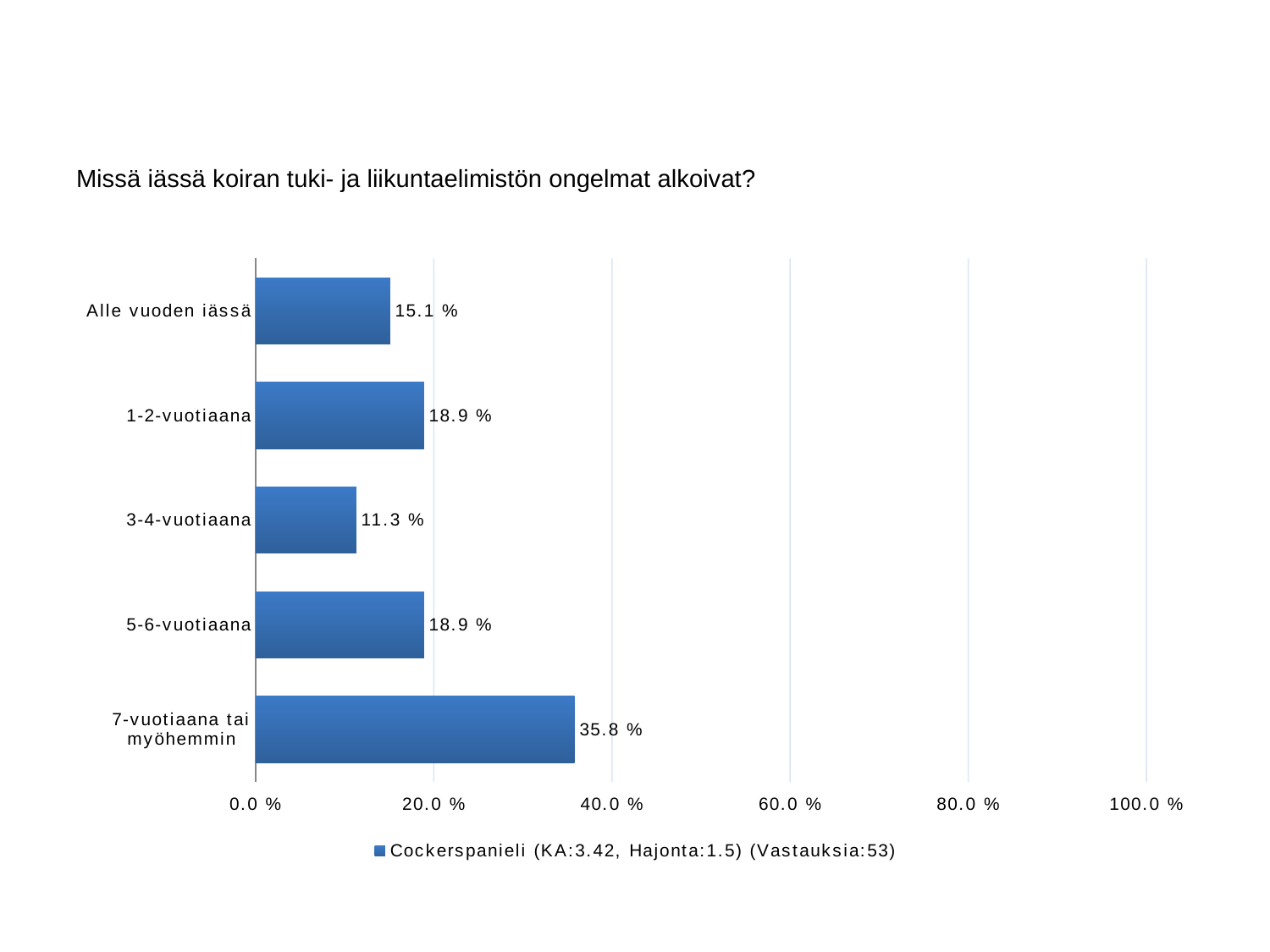
What is the value for "3-4-vuotiaana"? 11.3 % How many series does the legend list? 1 What is the title of the chart? Missä iässä koiran tuki- ja liikuntaelimistön ongelmat alkoivat? What is the difference between the values for "7-vuotiaana tai myöhemmin" and "1-2-vuotiaana"? 16.9 % What is the value for "7-vuotiaana tai myöhemmin"? 35.8 % Is the value for "7-vuotiaana tai myöhemmin" greater or less than 40.0 %? less Which is larger, the value for "Alle vuoden iässä" or the value for "3-4-vuotiaana"? Alle vuoden iässä What kind of chart is shown on the slide? bar chart What is the value for "Alle vuoden iässä"? 15.1 % How many categories are shown in the chart? 5 Which category has the lowest value? 3-4-vuotiaana Which category has the highest value? 7-vuotiaana tai myöhemmin